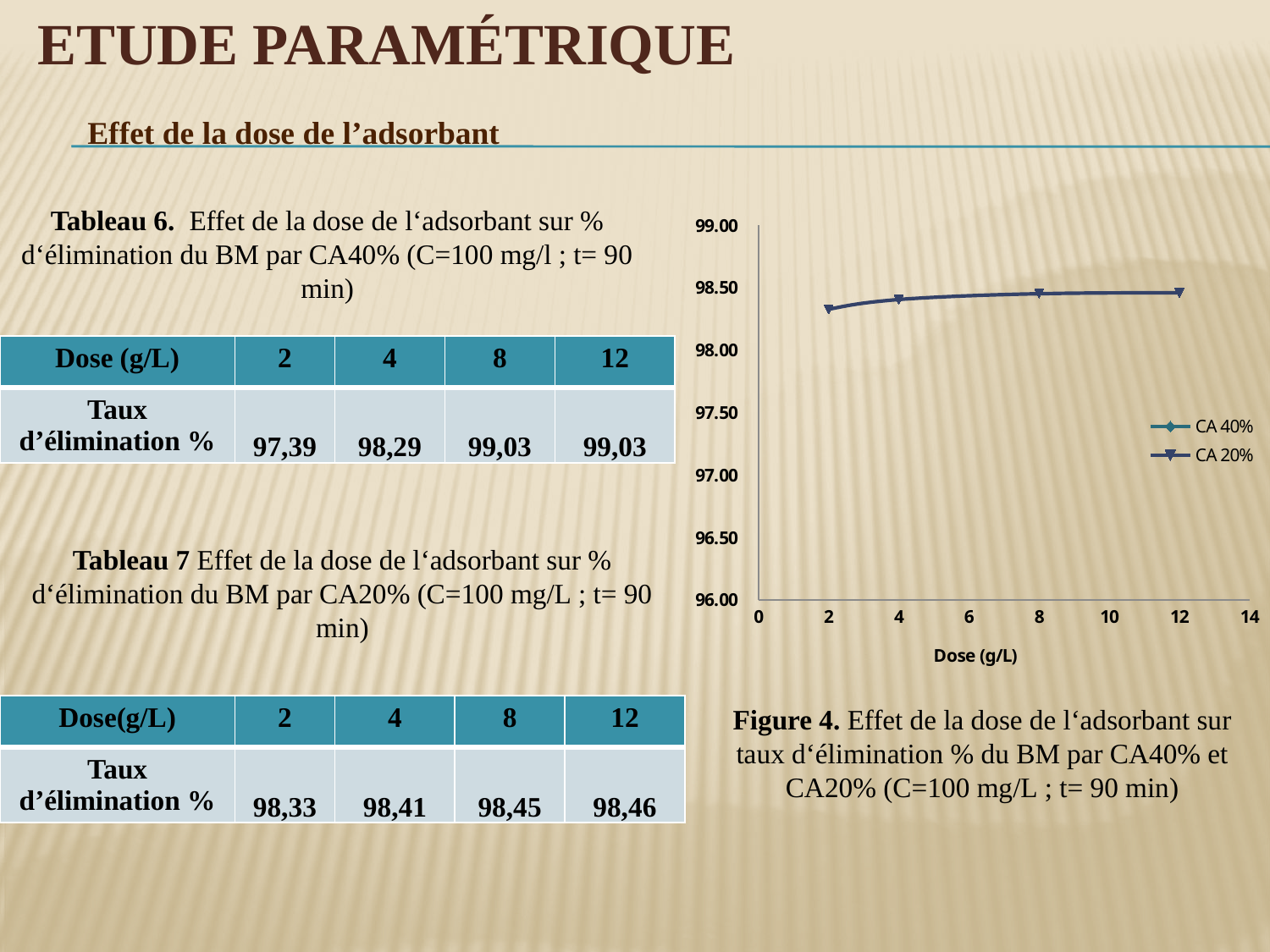
Is the plotted value at dose 2 g/L greater or less than 98.00? greater Is the plotted value at dose 4 g/L greater or less than 99.00? less What is the x-axis title of the chart? Dose (g/L) What is the highest value shown on the y axis of the chart? 99.00 How many series does the legend of the chart list? 2 What are the two series named in the chart legend? CA 40% and CA 20% What kind of chart is shown on the right of the slide? line chart Do the plotted values rise or fall as the dose increases along the x axis? rise How many data points are plotted on the visible line in the chart? 4 Is the plotted value at dose 8 g/L greater or less than 97.00? greater